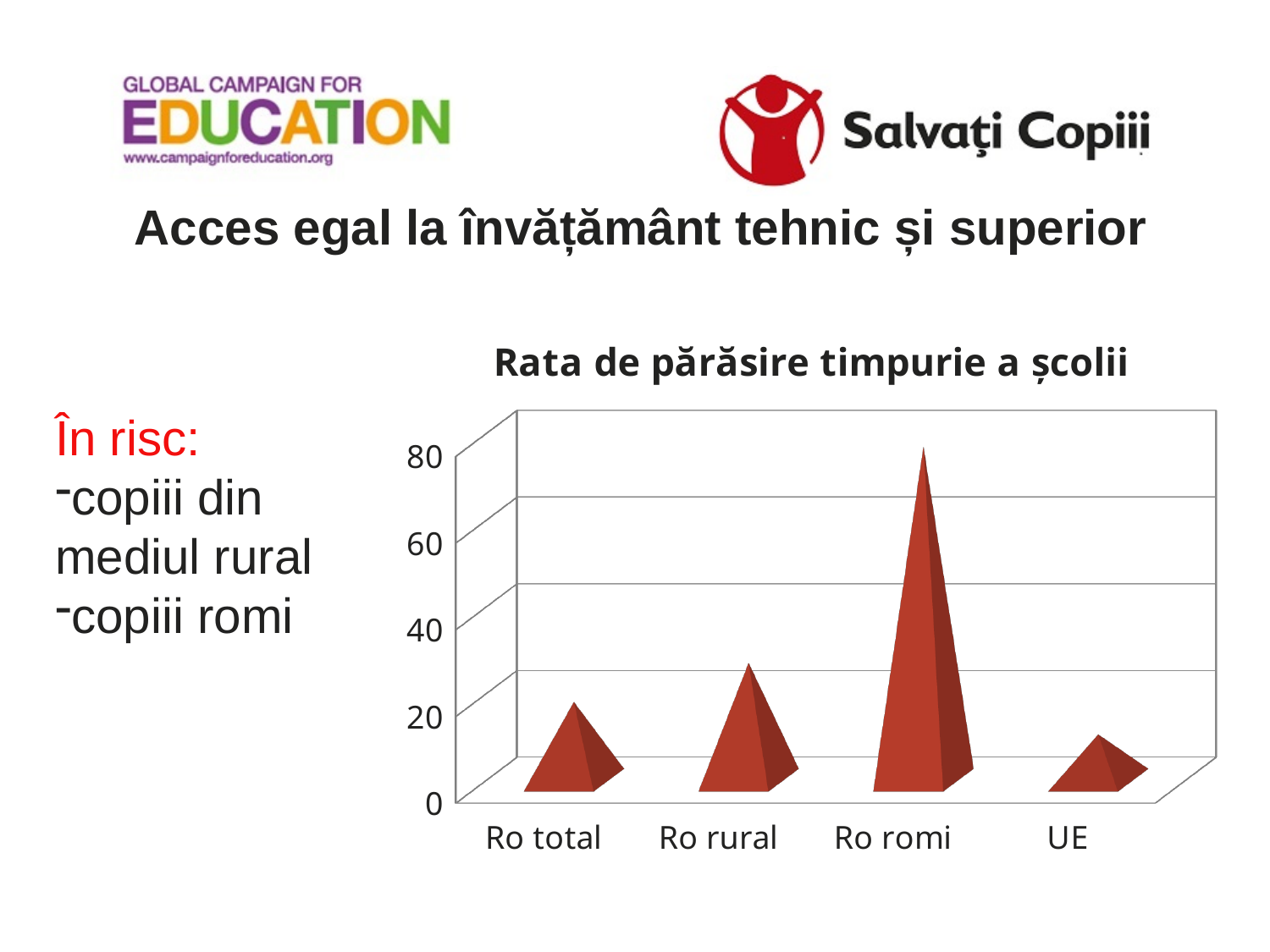
How many categories are shown on the x axis of the chart? 4 Is the value for Ro romi greater or less than 60? greater What kind of chart is shown on the slide? bar chart Which is larger, the value for Ro romi or the value for Ro rural? Ro romi Is the value for Ro total greater or less than 40? less Is the value for Ro rural greater or less than 40? less Which is larger, the value for Ro rural or the value for Ro total? Ro rural Which category has the highest value in the chart? Ro romi What is the title of the chart? Rata de părăsire timpurie a școlii What is the highest value labelled on the vertical axis of the chart? 80 Which category has the lowest value in the chart? UE